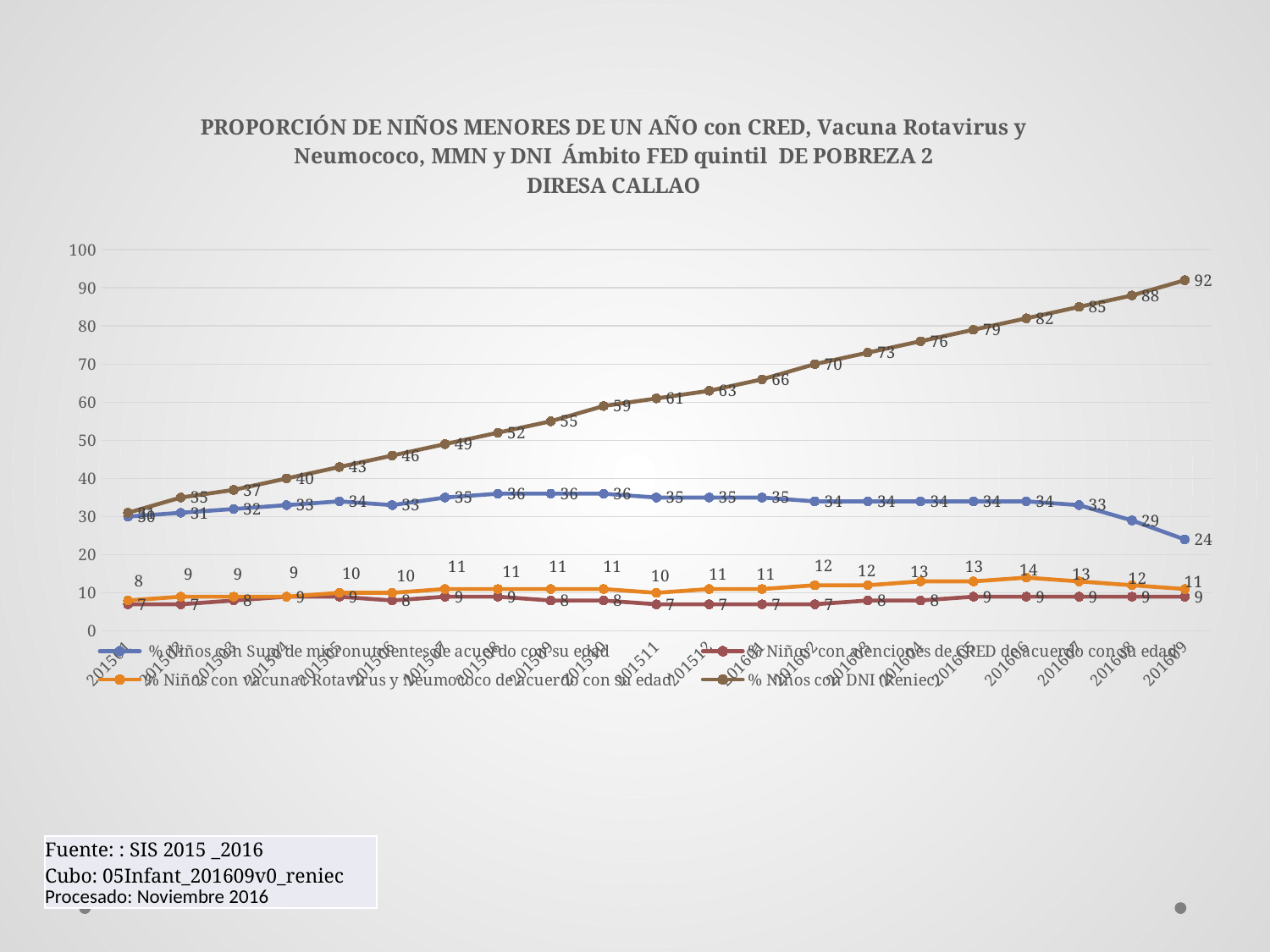
Which series reaches the highest value on the chart? % Niños con DNI (Reniec) What is the value of the '% Niños con DNI (Reniec)' series at the last point on the right (201609)? 92 How many series does the legend list? 4 Does the '% Niños con DNI (Reniec)' series rise or fall along the x axis? rise What kind of chart is shown on the slide? line chart At the last point on the right (201609), which is larger: the '% Niños con Supl de micronutrientes' value or the '% Niños con Vacuna Rotavirus y Neumococo' value? % Niños con Supl de micronutrientes What is the highest value reached by the '% Niños con Vacuna Rotavirus y Neumococo de acuerdo con su edad' series? 14 What is the value of the '% Niños con Supl de micronutrientes de acuerdo con su edad' series at the last point on the right (201609)? 24 How many data points does the '% Niños con DNI (Reniec)' series have? 21 What is the difference between the last value (92) and the first value (31) of the '% Niños con DNI (Reniec)' series? 61 What is the value of the '% Niños con DNI (Reniec)' series at the first point on the left? 31 What is the lowest value of the '% Niños con atenciones de CRED de acuerdo con su edad' series? 7